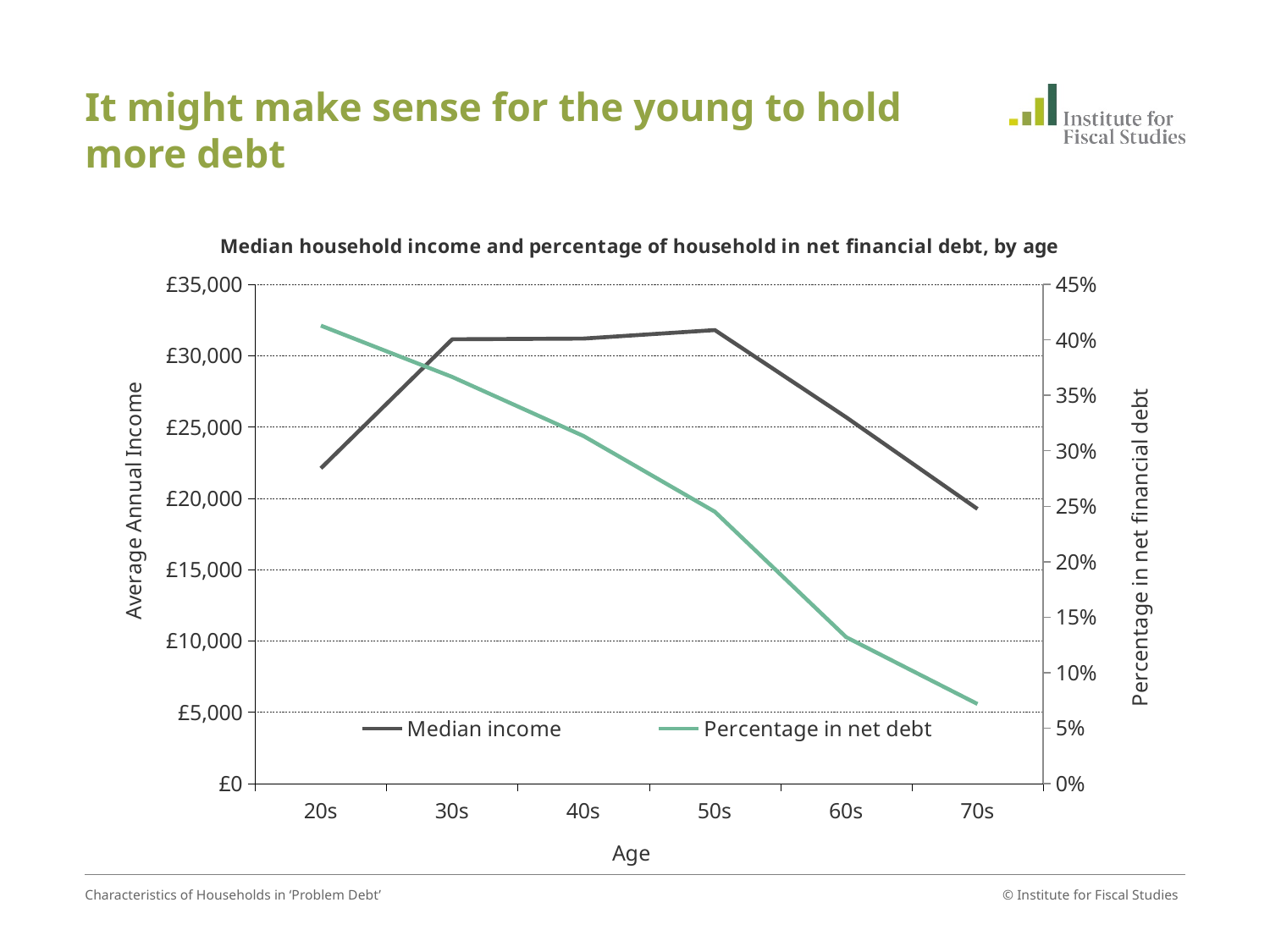
Is the percentage in net debt for the 60s greater or less than 15%? less What kind of chart is shown on the slide? line chart Is the median income for the 20s greater or less than £25,000? less How many age groups are plotted along the x axis? 6 Is the percentage in net debt for the 20s greater or less than 35%? greater Which age group has the highest percentage in net financial debt? 20s Which is larger, the median income for the 30s or for the 70s? 30s Which age group has the lowest percentage in net financial debt? 70s Which age group has the lowest median income? 70s Does the percentage in net debt rise or fall as age increases from 20s to 70s? fall How many series does the legend list? 2